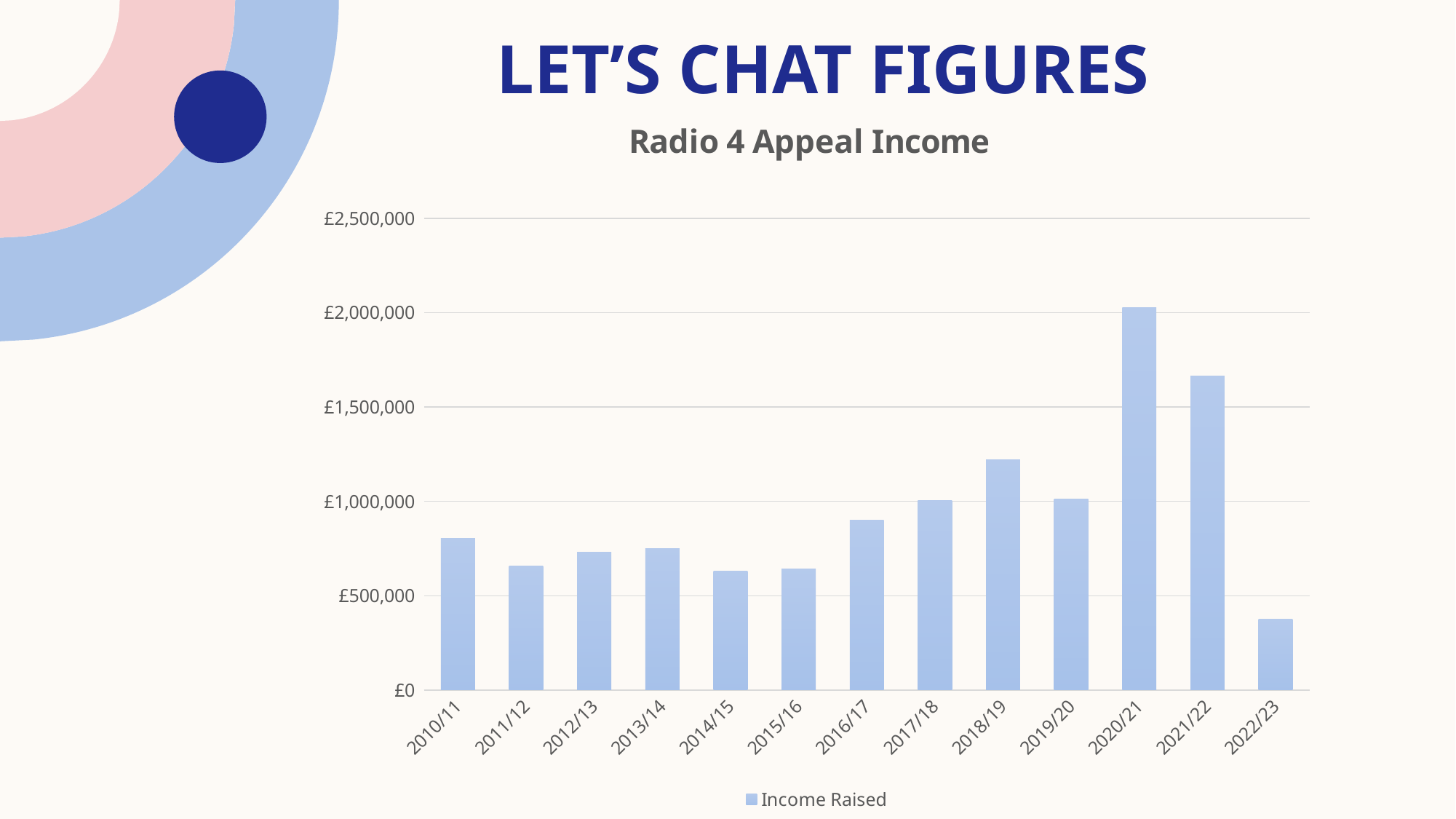
Is the value for 2020/21 greater or less than £1,500,000? greater Do the values rise or fall from 2020/21 to 2022/23? fall Which year has the lowest income raised? 2022/23 Is the value for 2022/23 greater or less than £500,000? less Which year has the highest income raised? 2020/21 What is the title of the chart? Radio 4 Appeal Income Is the value for 2018/19 greater or less than £1,000,000? greater Which year has the larger income raised, 2020/21 or 2021/22? 2020/21 How many series does the legend list? 1 How many years are shown on the x axis? 13 What kind of chart is shown on the slide? bar chart